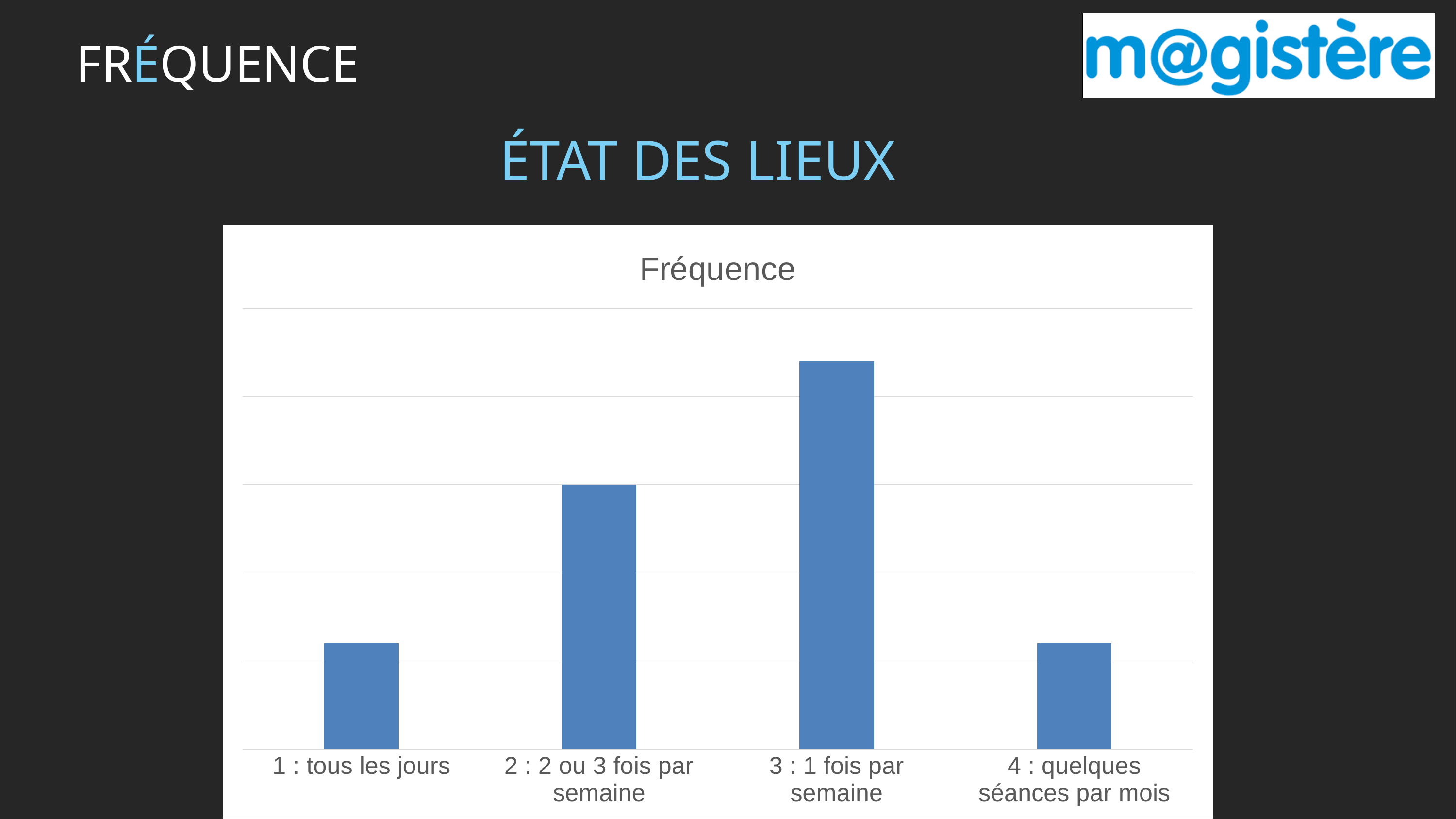
Which bar is taller: '2 : 2 ou 3 fois par semaine' or '4 : quelques séances par mois'? 2 : 2 ou 3 fois par semaine Which bar is taller: '1 : tous les jours' or '2 : 2 ou 3 fois par semaine'? 2 : 2 ou 3 fois par semaine Which bar is taller: '3 : 1 fois par semaine' or '4 : quelques séances par mois'? 3 : 1 fois par semaine Which category has the highest bar in the chart? 3 : 1 fois par semaine What is the label of the first category on the x axis? 1 : tous les jours What type of chart is shown on the slide? bar chart What is the title of the chart? Fréquence How many categories are shown on the x axis of the chart? 4